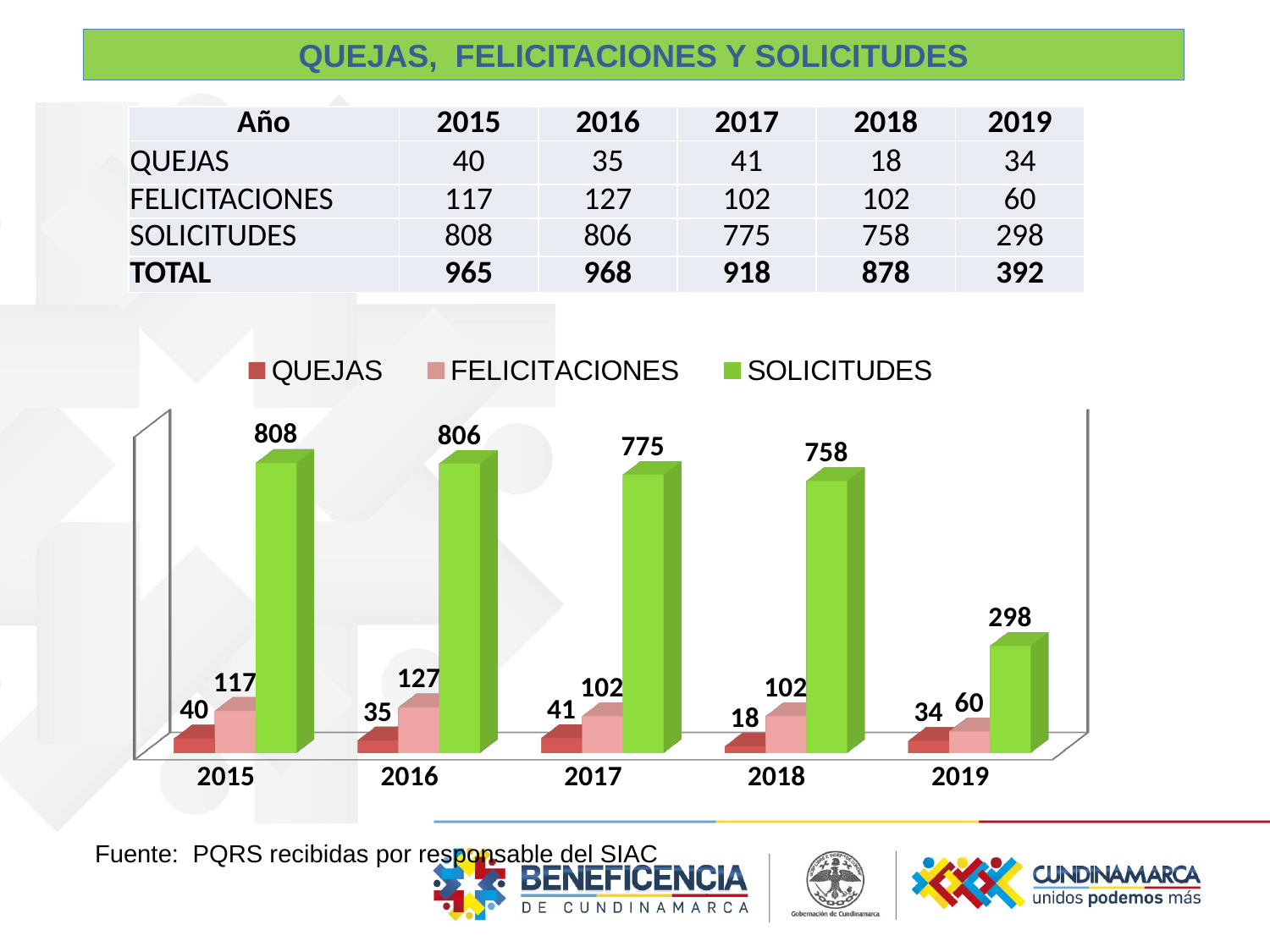
Which is larger in the chart: QUEJAS for 2017 or QUEJAS for 2019? QUEJAS for 2017 Which year has the lowest QUEJAS value in the chart? 2018 Which year has the highest SOLICITUDES value in the chart? 2015 Which colour represents SOLICITUDES in the chart legend? Green What kind of chart is shown on the slide? Bar chart How many years are shown on the x axis of the chart? 5 What is the difference between the SOLICITUDES values for 2018 and 2019 in the chart? 460 What is the value of FELICITACIONES for 2016 in the chart? 127 What is the value of SOLICITUDES for 2017 in the chart? 775 Do the SOLICITUDES values rise or fall from 2015 to 2019 in the chart? Fall How many series does the chart legend list? 3 What is the value of QUEJAS for 2018 in the chart? 18